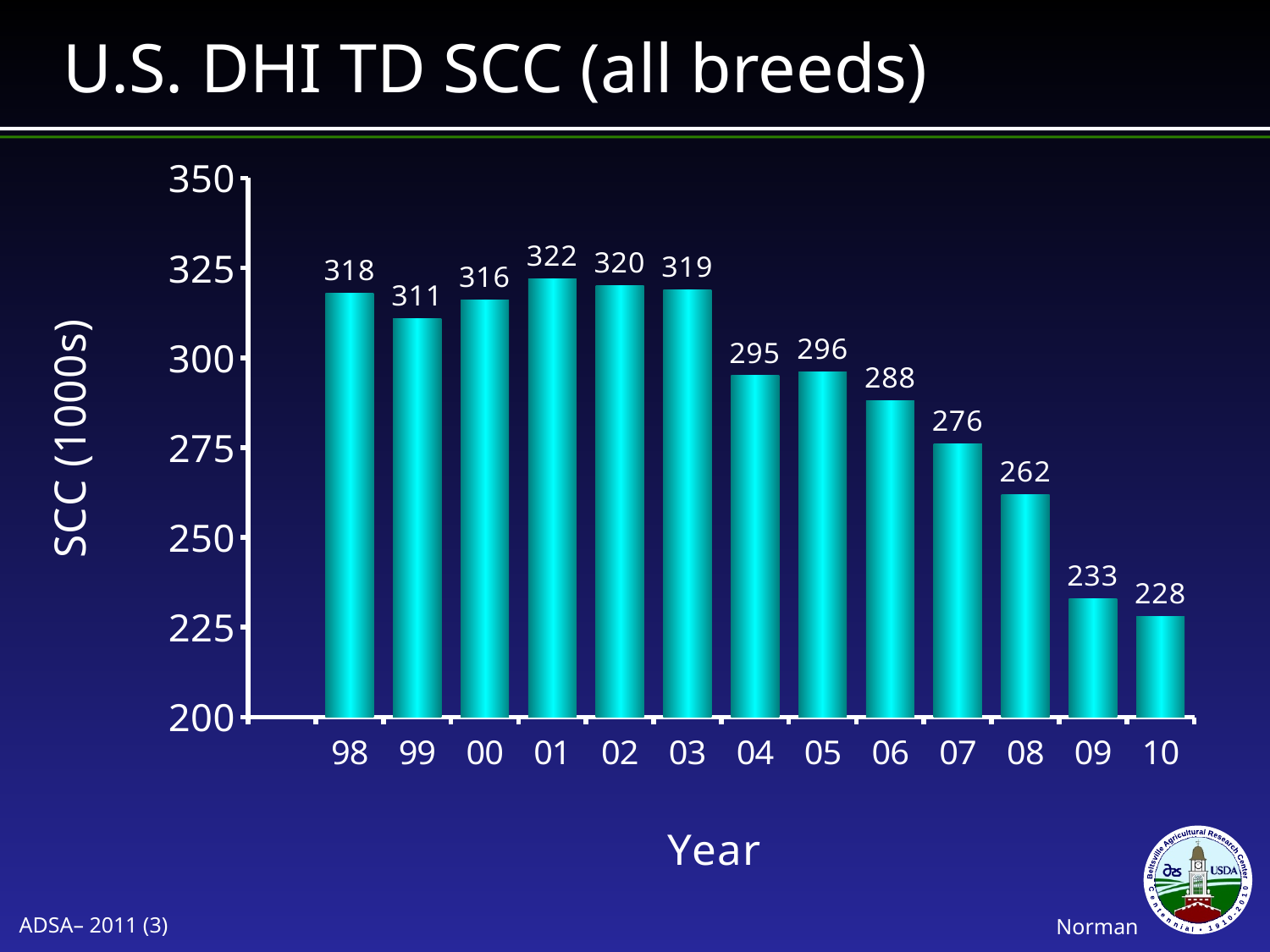
What is the difference between the SCC values for 98 and 10? 90 Which year has the lowest SCC value? 10 Is the SCC value for 08 greater or less than 250? greater How many years are shown on the x axis? 13 What is the difference between the SCC values for 08 and 09? 29 What is the SCC value for the year 07? 276 Which year has the highest SCC value? 01 Do the SCC values generally rise or fall from 03 to 10? fall What kind of chart is shown on the slide? bar chart What is the SCC value for the year 01? 322 Which year has a larger SCC value, 04 or 06? 04 What is the SCC value for the year 10? 228